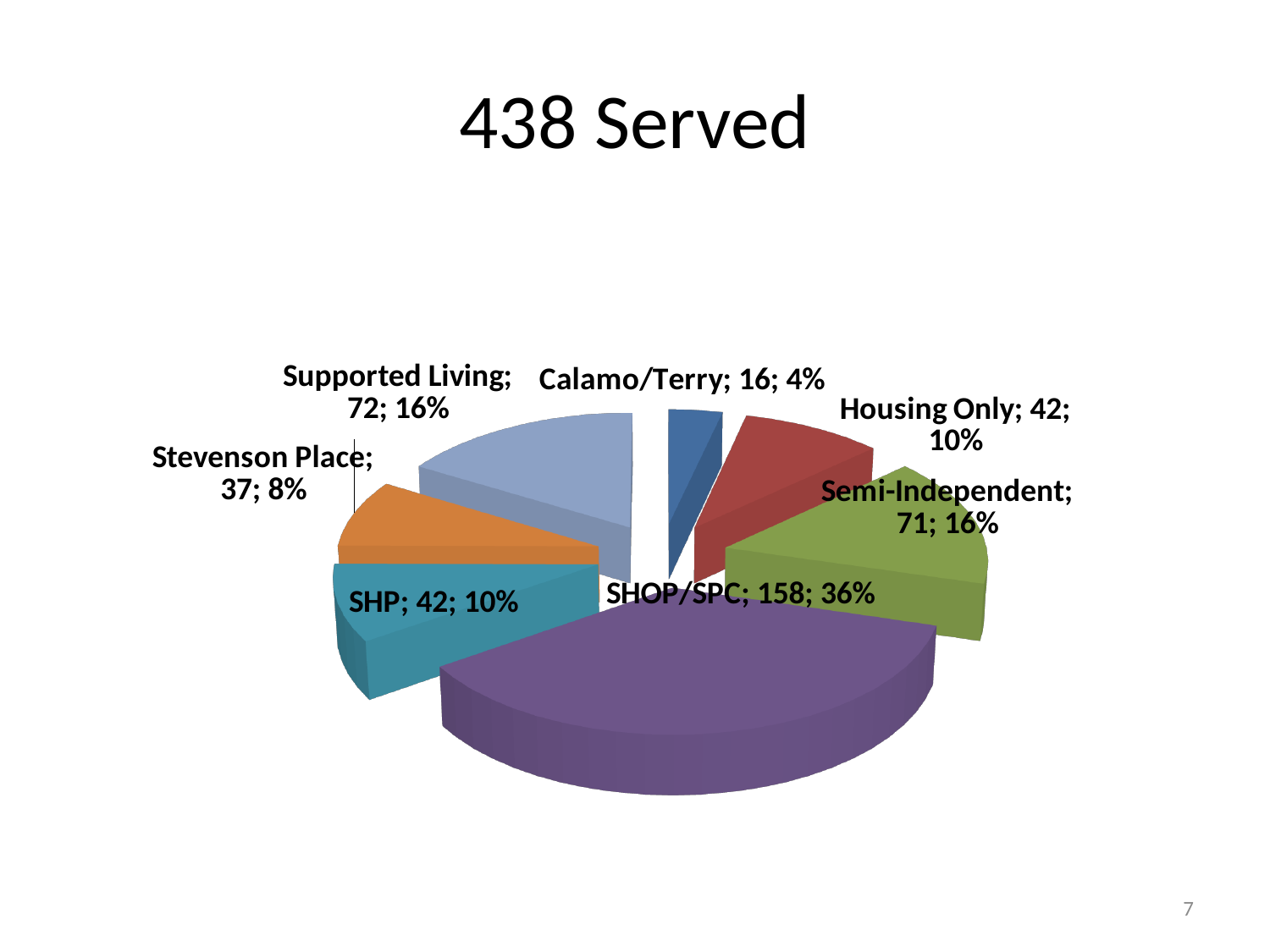
What is the value for Stevenson Place? 37 What is the difference between the SHOP/SPC value and the Semi-Independent value? 87 What percentage share does SHOP/SPC have? 36% Which is larger, the value for Housing Only or the value for Calamo/Terry? Housing Only Which category has the largest slice? SHOP/SPC What is the title of the chart? 438 Served Which category has the smallest slice? Calamo/Terry What percentage share does Supported Living have? 16% How many slices does the pie chart have? 7 What kind of chart is shown on the slide? pie chart What is the value for Semi-Independent? 71 How many people were served by SHOP/SPC? 158